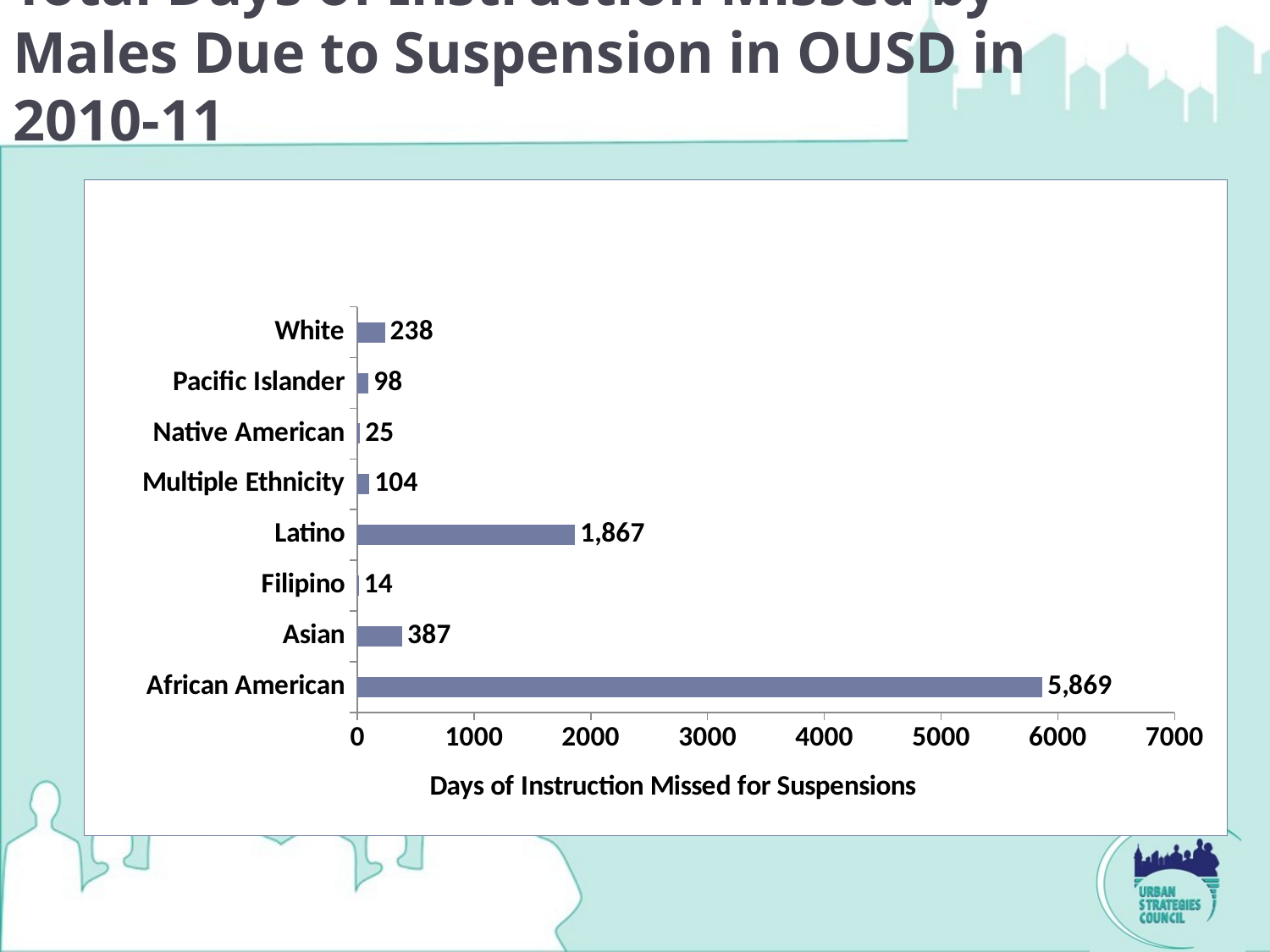
What is the value shown for Latino? 1,867 What kind of chart is shown on the slide? Bar chart How many days of instruction were missed by African American males due to suspension? 5,869 Which is larger, the value for White or the value for Asian? Asian How many ethnic groups are shown in the chart? 8 What is the value shown for Multiple Ethnicity? 104 Which group has the highest number of days of instruction missed? African American Is the value for African American greater or less than 5000? greater Which group has the lowest number of days of instruction missed? Filipino What is the difference between the values for Asian and White? 149 What is the difference between the values for African American and Latino? 4,002 What is the value shown for Pacific Islander? 98